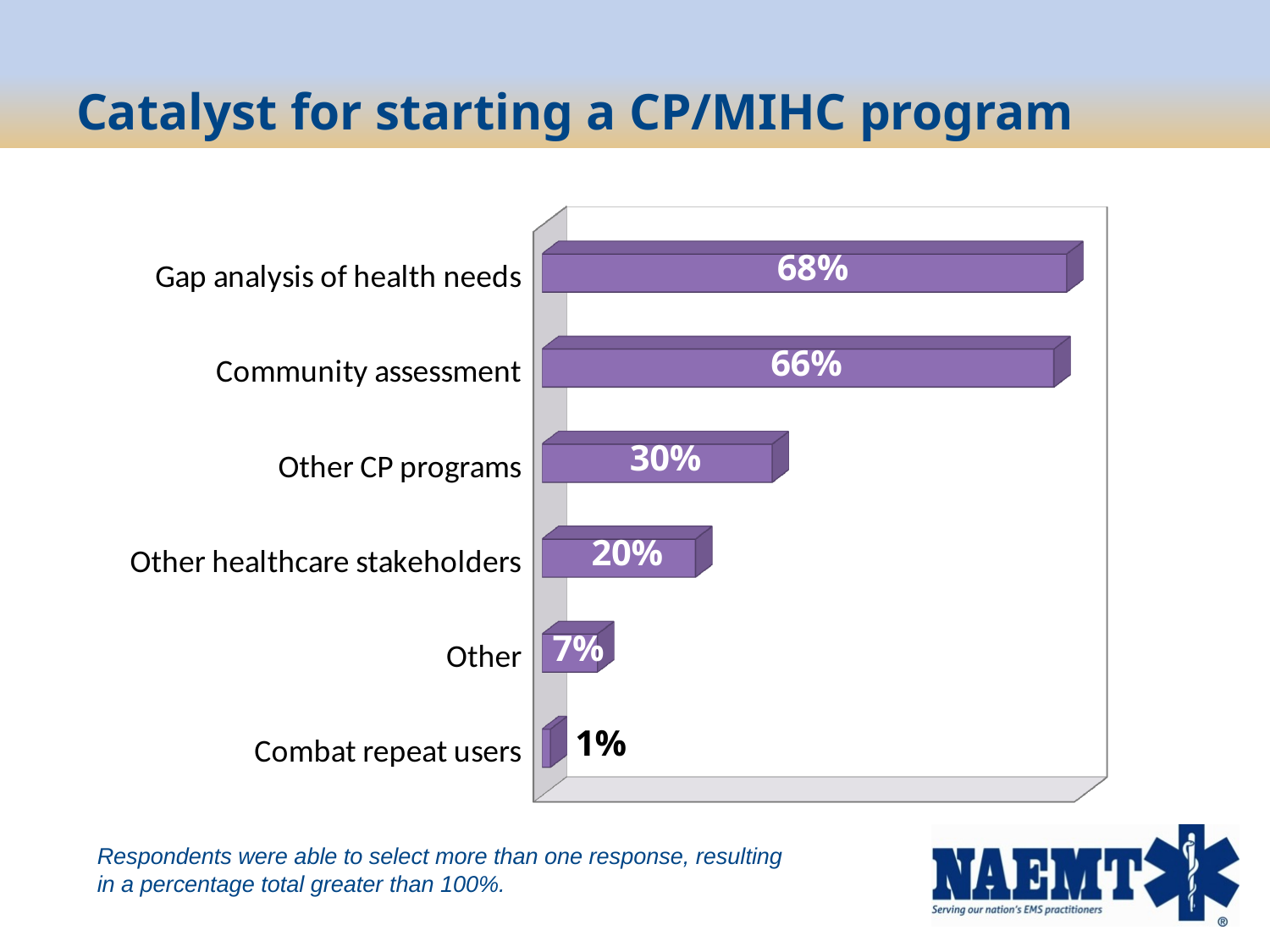
What percentage is shown for Combat repeat users? 1% What is the value for Community assessment? 66% Which catalyst has the highest percentage? Gap analysis of health needs What kind of chart is shown on the slide? Bar chart What percentage of respondents cited gap analysis of health needs as a catalyst? 68% Which is larger, the value for Other CP programs or the value for Other? Other CP programs What is the value for Other healthcare stakeholders? 20% What is the difference between the values for Other CP programs and Other healthcare stakeholders? 10% What is the difference between the values for Gap analysis of health needs and Community assessment? 2% Which catalyst has the lowest percentage? Combat repeat users What percentage is shown for Other CP programs? 30% How many categories are shown in the chart? 6